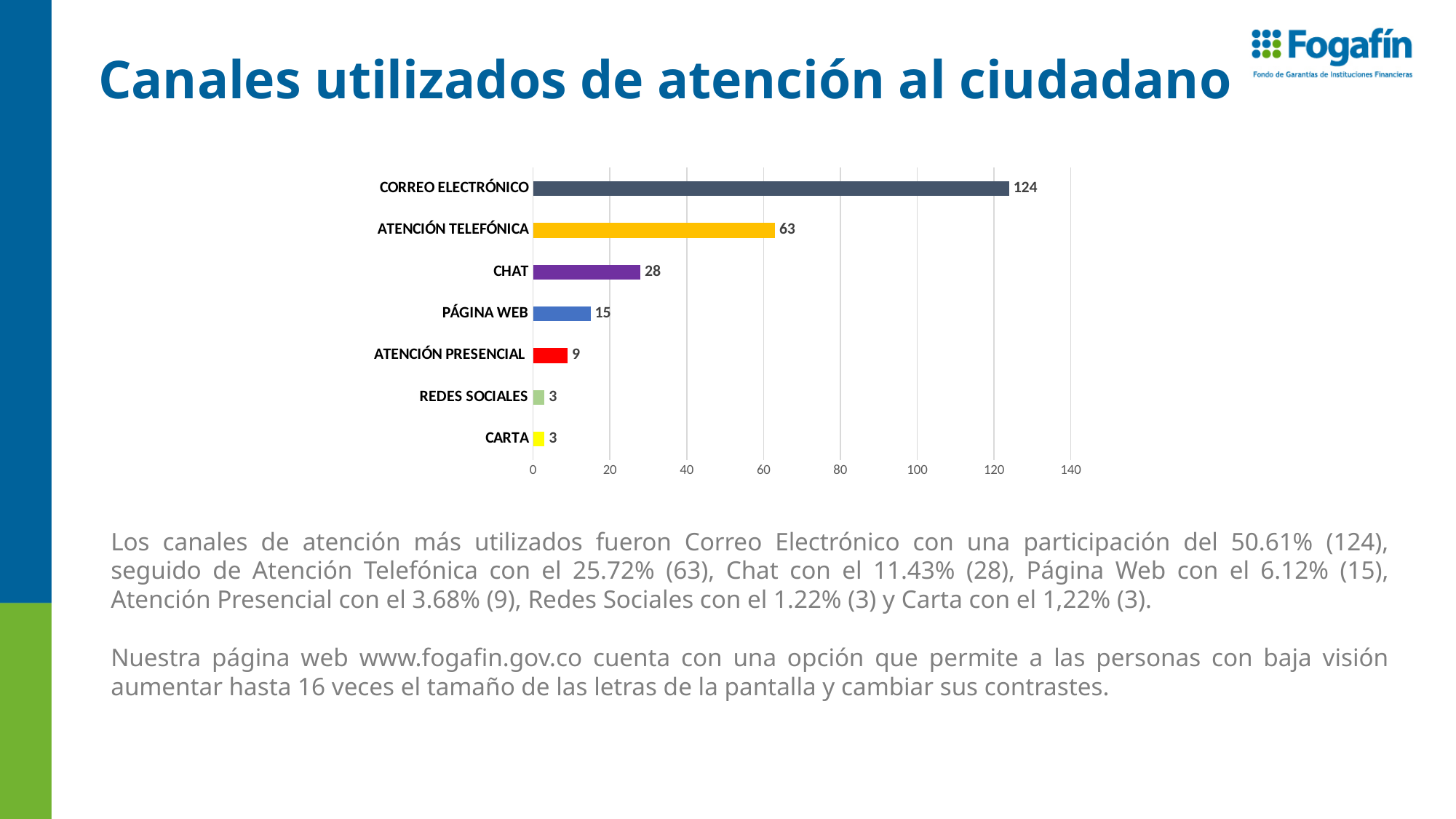
What is the value for ATENCIÓN PRESENCIAL? 9 What is the difference between the values for CHAT and PÁGINA WEB? 13 What is the highest value shown on the horizontal axis? 140 What is the difference between the values for CORREO ELECTRÓNICO and ATENCIÓN TELEFÓNICA? 61 Which category has the highest value? CORREO ELECTRÓNICO Is the value for ATENCIÓN TELEFÓNICA greater or less than 80? less What kind of chart is shown on the slide? bar chart What is the value for ATENCIÓN TELEFÓNICA? 63 How many categories are shown in the chart? 7 What is the value for PÁGINA WEB? 15 What is the value for CORREO ELECTRÓNICO? 124 Which is larger, the value for CHAT or the value for ATENCIÓN PRESENCIAL? CHAT